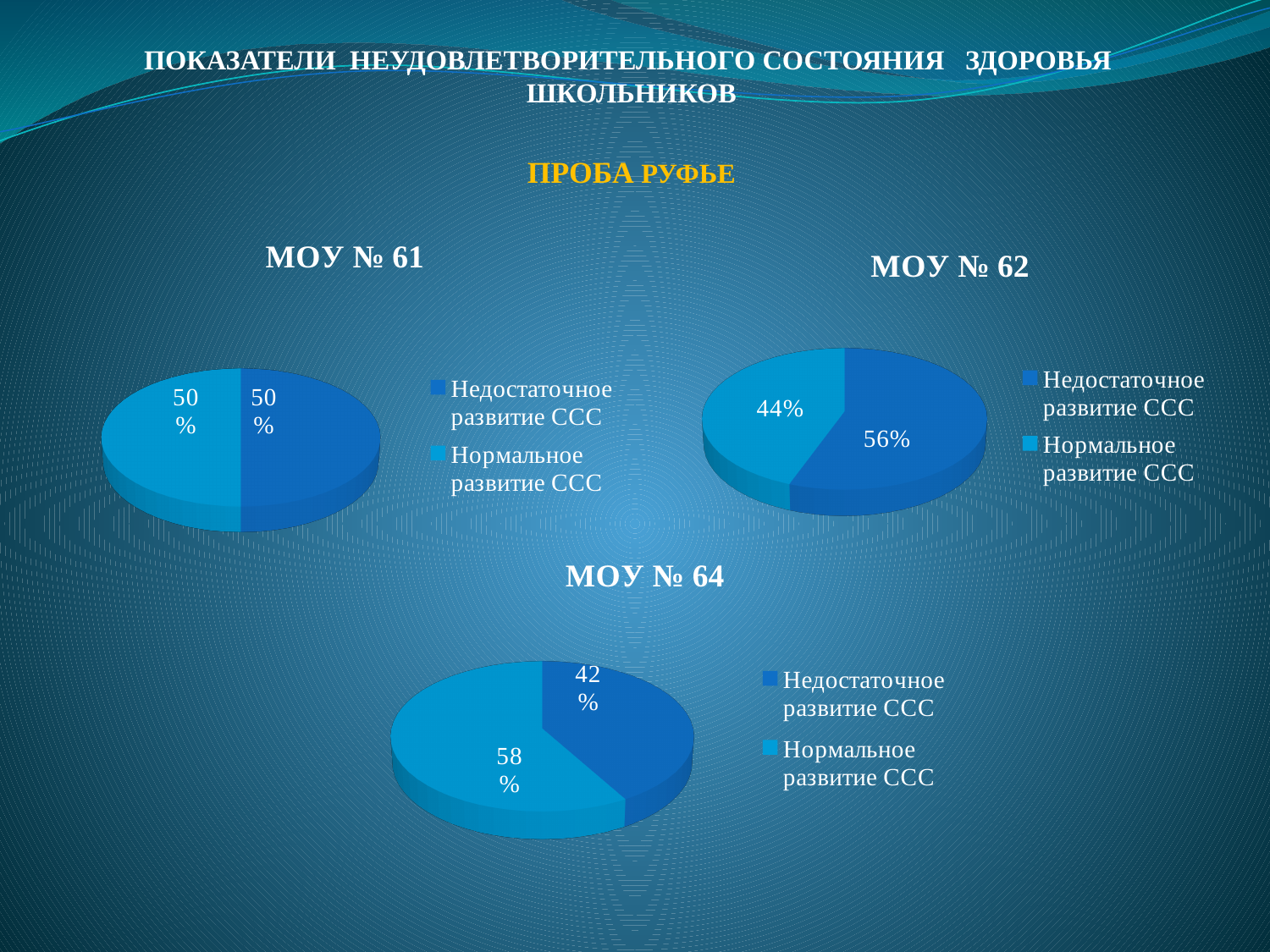
In the МОУ № 64 chart, what share is labelled for Нормальное развитие ССС? 58% In the МОУ № 64 chart, what share is labelled for Недостаточное развитие ССС? 42% How many entries does the legend of the МОУ № 61 chart list? 2 In the МОУ № 64 chart, which category has the largest slice? Нормальное развитие ССС In the МОУ № 62 chart, what share is labelled for Нормальное развитие ССС? 44% In the МОУ № 62 chart, what is the difference between the Недостаточное развитие ССС and Нормальное развитие ССС shares? 12% How many charts are shown on the slide? 3 In the МОУ № 61 chart, what share is labelled for Нормальное развитие ССС? 50% In the МОУ № 62 chart, what share is labelled for Недостаточное развитие ССС? 56% In the МОУ № 64 chart, which is larger: Недостаточное развитие ССС or Нормальное развитие ССС? Нормальное развитие ССС In the МОУ № 62 chart, which category has the smallest slice? Нормальное развитие ССС What type of chart is the МОУ № 62 chart? Pie chart